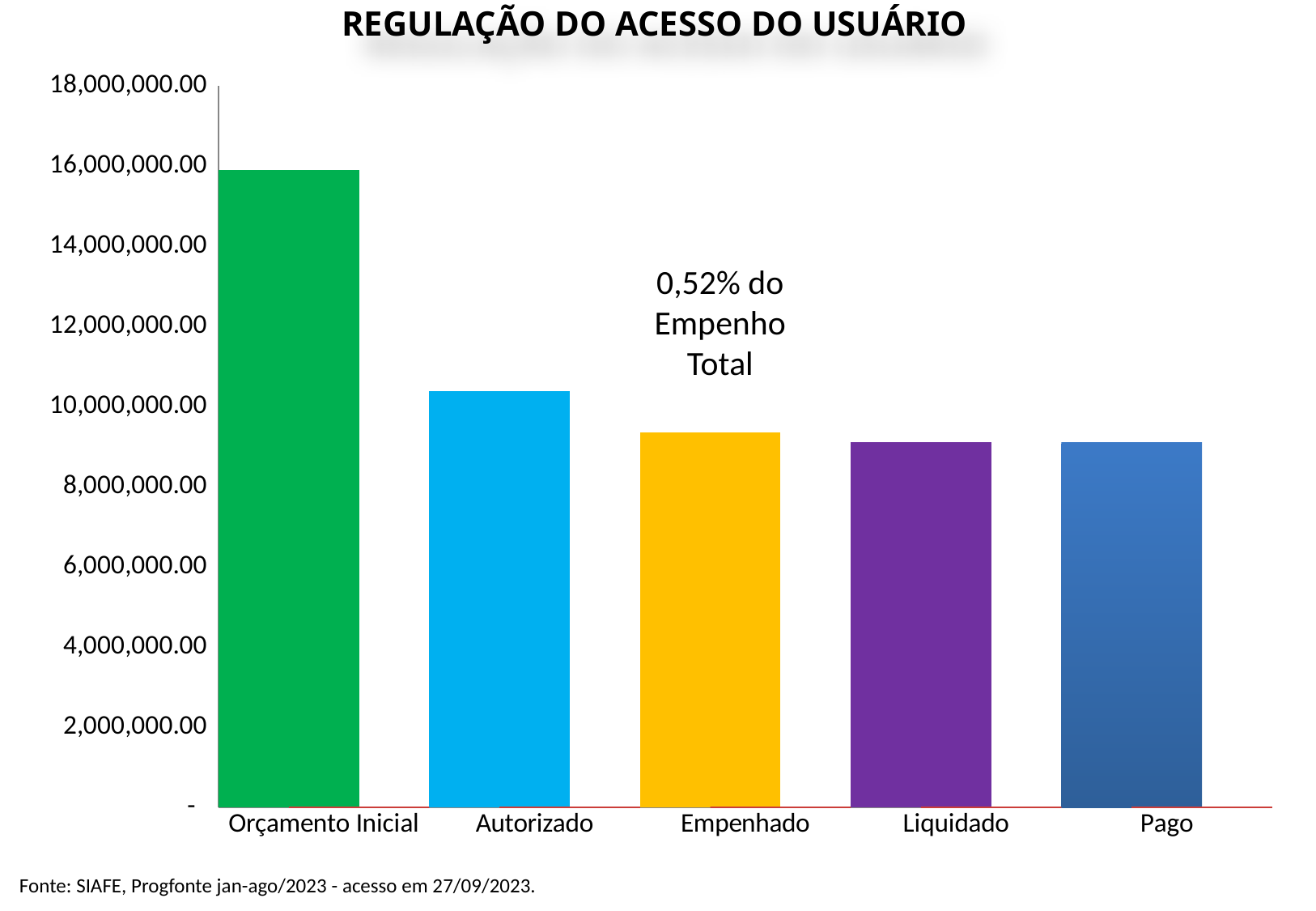
Do the values generally rise or fall from left to right along the x axis? fall Is the value for Empenhado greater or less than 10,000,000.00? less What is the title of the chart? REGULAÇÃO DO ACESSO DO USUÁRIO Is the value for Orçamento Inicial greater or less than 14,000,000.00? greater Which is larger, the value for Orçamento Inicial or the value for Autorizado? Orçamento Inicial Which category has the highest value in the chart? Orçamento Inicial Is the value for Liquidado greater or less than 8,000,000.00? greater What kind of chart is shown on the slide? bar chart How many categories are shown on the x axis of the chart? 5 Which is larger, the value for Autorizado or the value for Empenhado? Autorizado